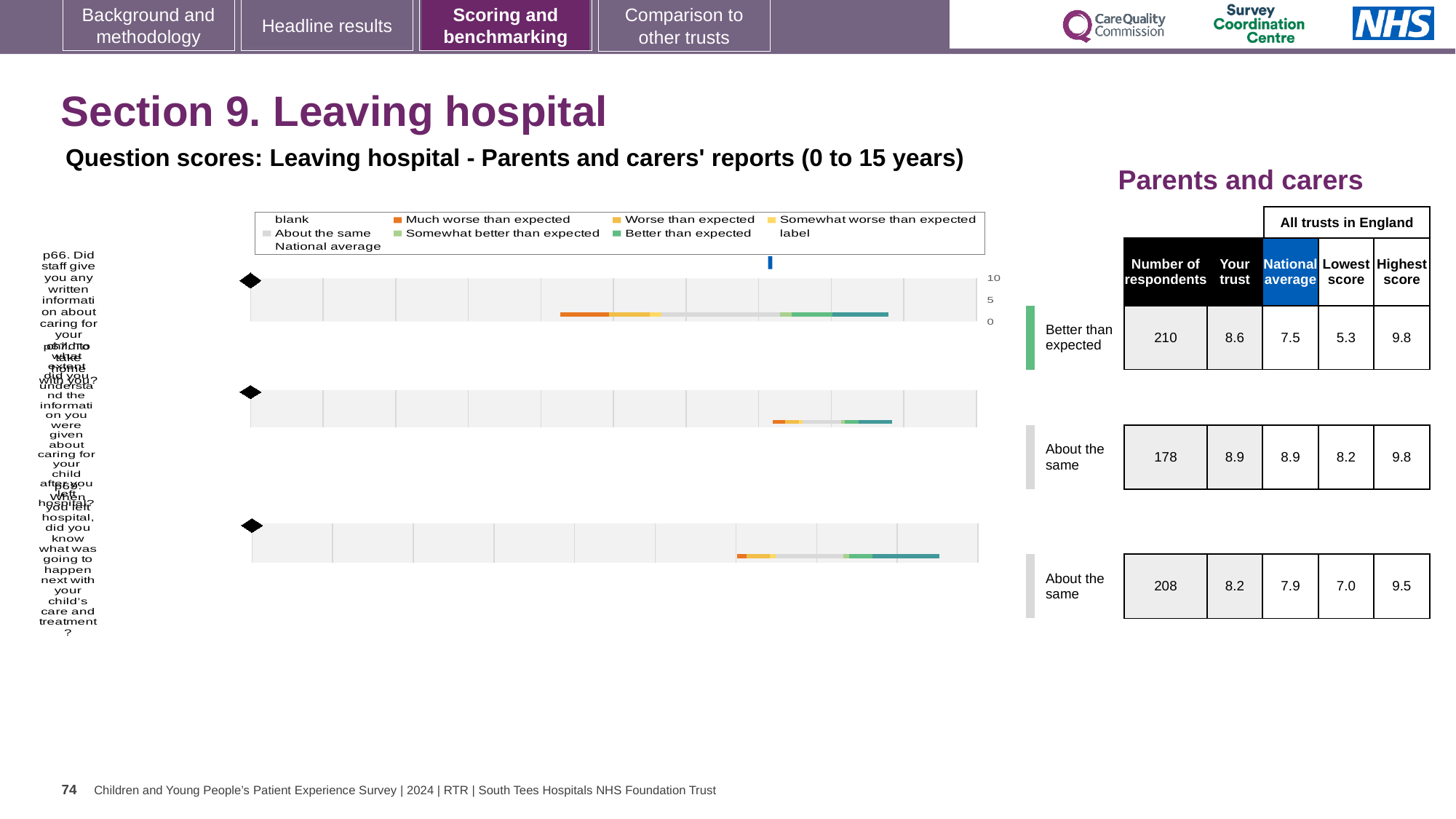
In the table beside the charts, what is the highest 'Your trust' score across the three rows? 8.9 In the table beside the charts, what is the number of respondents for the second row? 178 How many separate question bar charts are shown on the slide? 3 What colour represents 'Much worse than expected' in the chart legend? orange In the table beside the charts, is the 'Your trust' score for the third row higher or lower than the national average? higher In the table beside the charts, what is the highest score for the third row? 9.5 In the table beside the charts, what is the 'Your trust' score for the first row (Better than expected)? 8.6 In the table beside the charts, what is the difference between 'Your trust' and the national average for the first row? 1.1 What kind of chart is used to show the question scores on this slide? bar chart In the table beside the charts, what is the smallest value in the 'Lowest score' column? 5.3 In the table beside the charts, what is the national average for the third row? 7.9 What is the maximum value shown on the x axis of the bar charts? 10